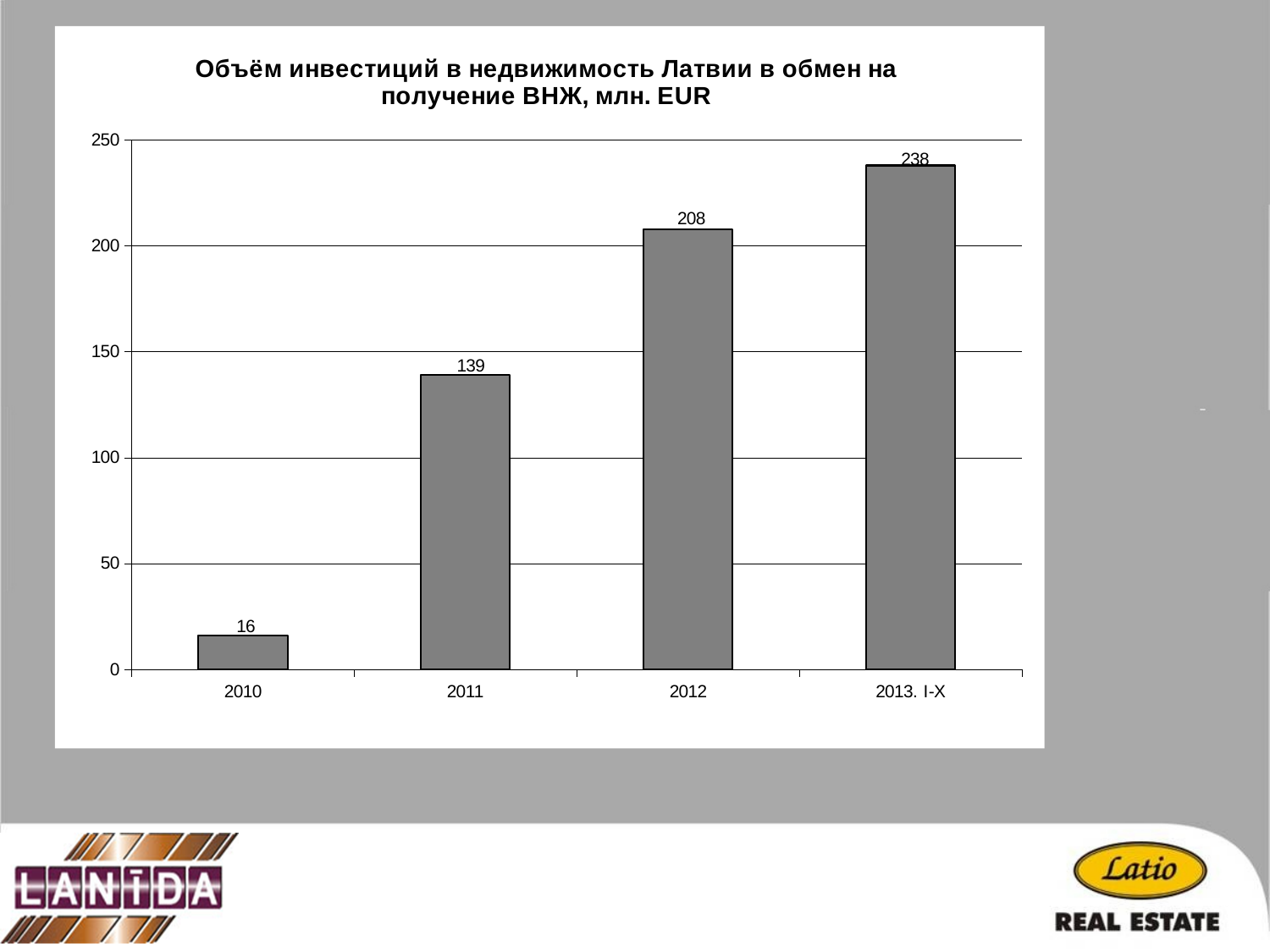
Is the value for 2011 greater or less than 100? greater What kind of chart is shown on the slide? bar chart What is the value for 2010? 16 What is the value for 2013. I-X? 238 What is the value for 2011? 139 Which category has the highest value? 2013. I-X Which is larger, the value for 2011 or the value for 2012? 2012 How many categories are shown on the x axis? 4 What is the value for 2012? 208 What is the difference between the values for 2012 and 2011? 69 Which category has the lowest value? 2010 Do the values rise or fall from 2010 to 2013. I-X? rise